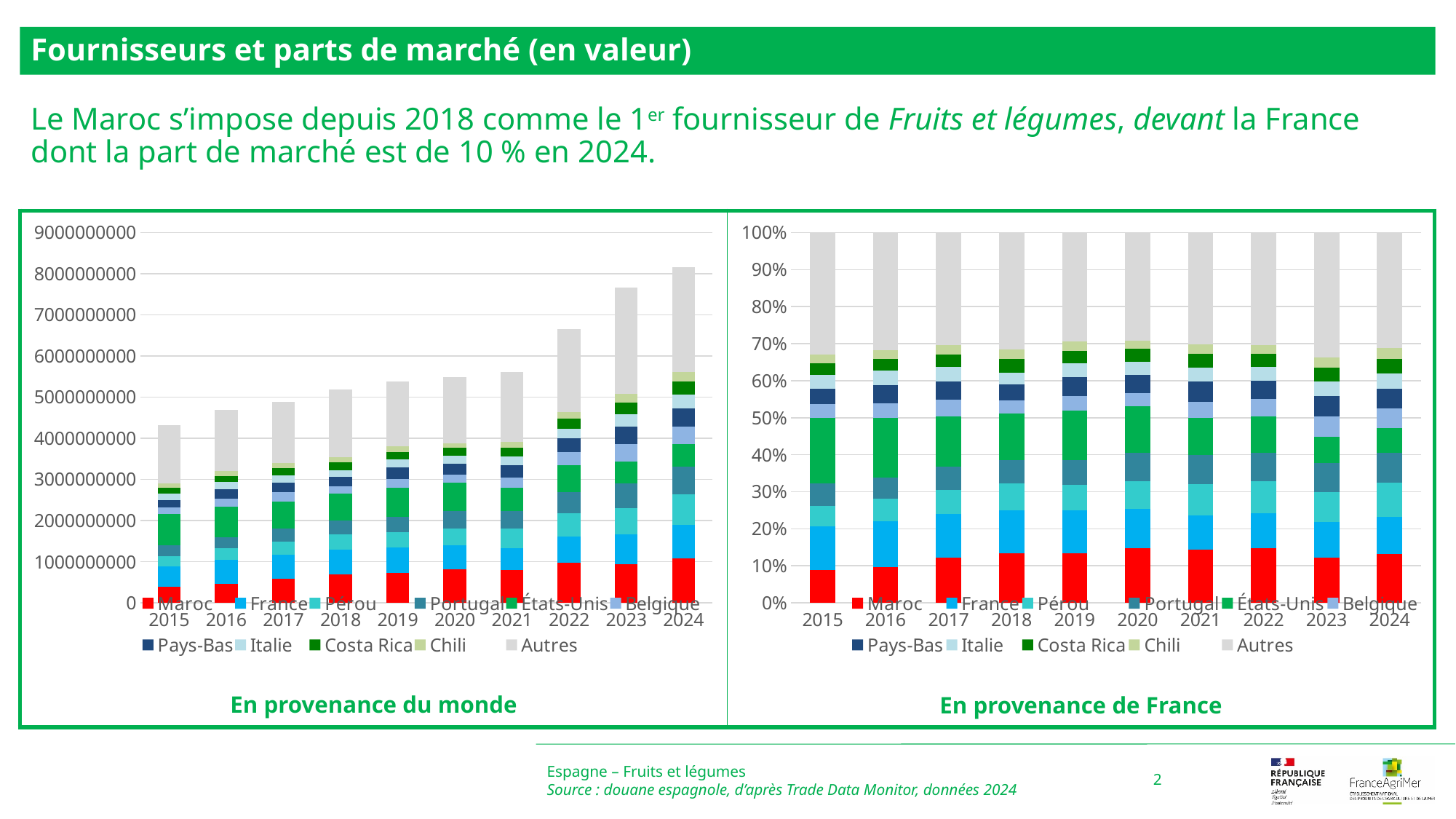
What kind of chart is the right chart, 'En provenance de France'? stacked bar chart In the left chart 'En provenance du monde', how many years are shown on the x axis? 10 In the right chart 'En provenance de France', is the Maroc share in 2024 greater or less than 10%? greater In the left chart 'En provenance du monde', which year has the lowest total bar? 2015 In the left chart 'En provenance du monde', which year has the highest total bar? 2024 In the right chart 'En provenance de France', how many series does the legend list? 11 What kind of chart is the left chart, 'En provenance du monde'? stacked bar chart In the left chart 'En provenance du monde', is the total bar for 2015 greater or less than 5000000000? less In the left chart 'En provenance du monde', do the total bar heights rise or fall from 2015 to 2024? rise In the left chart 'En provenance du monde', is the total bar for 2023 greater or less than 7000000000? greater In the left chart 'En provenance du monde', which colour represents Maroc in the legend? red In the right chart 'En provenance de France', what is the highest value shown on the y axis? 100%